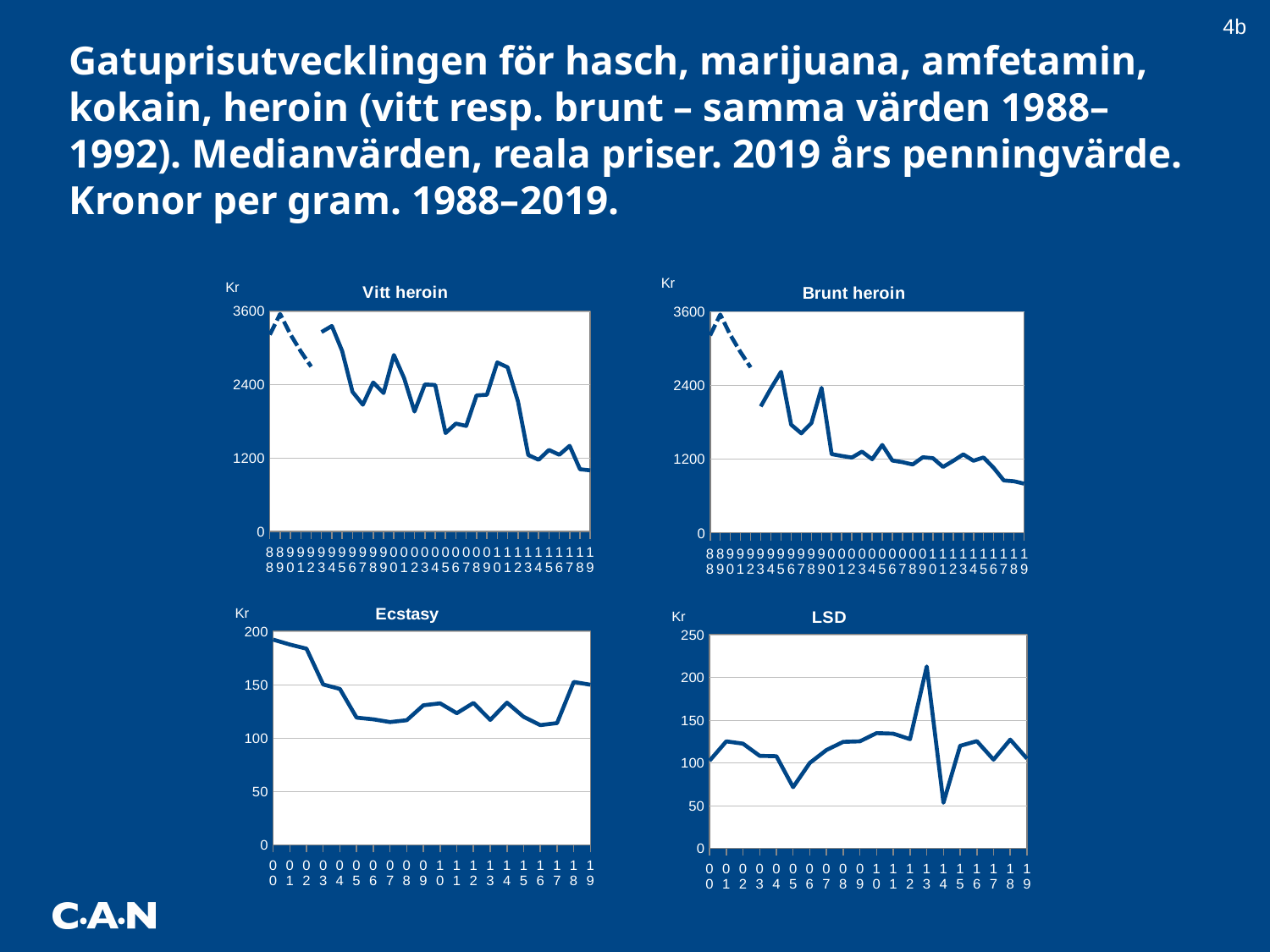
In the "LSD" chart, which year has the highest value? 2013 How many charts are shown on the slide? 4 What are the titles of the four charts on the slide? Vitt heroin, Brunt heroin, Ecstasy, LSD In the "LSD" chart, is the value for 2014 greater or less than 100? less In the "Ecstasy" chart, is the value for 2000 greater or less than 150? greater In the "LSD" chart, which year has the lowest value? 2014 In the "Brunt heroin" chart, do the values generally rise or fall from 1988 to 2019? fall What kind of chart is the "Ecstasy" chart? line chart In the "Brunt heroin" chart, is the value for 2019 greater or less than 1200? less What unit is shown at the top of the y axis of the "LSD" chart? Kr